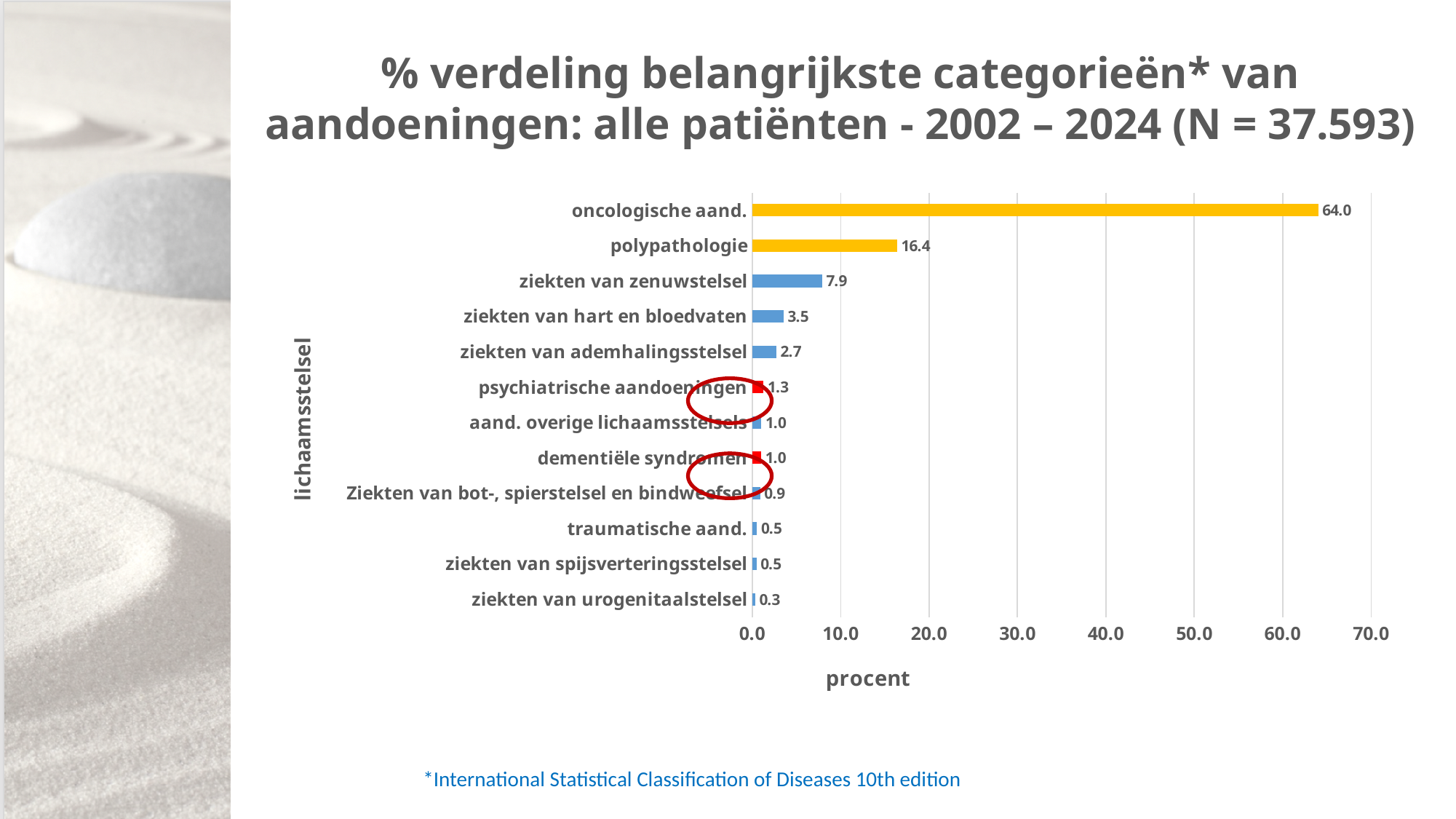
What is the value for polypathologie? 16.4 Is the value for oncologische aand. greater or less than 60.0? greater How many categories are shown on the chart? 12 Which category has the lowest value? ziekten van urogenitaalstelsel Which category has the highest value? oncologische aand. What is the difference between the values for oncologische aand. and polypathologie? 47.6 What is the label of the horizontal axis? procent What kind of chart is shown on the slide? bar chart Which is larger, the value for ziekten van hart en bloedvaten or the value for ziekten van ademhalingsstelsel? ziekten van hart en bloedvaten What is the value for ziekten van zenuwstelsel? 7.9 What is the value for oncologische aand.? 64.0 What is the value for psychiatrische aandoeningen? 1.3